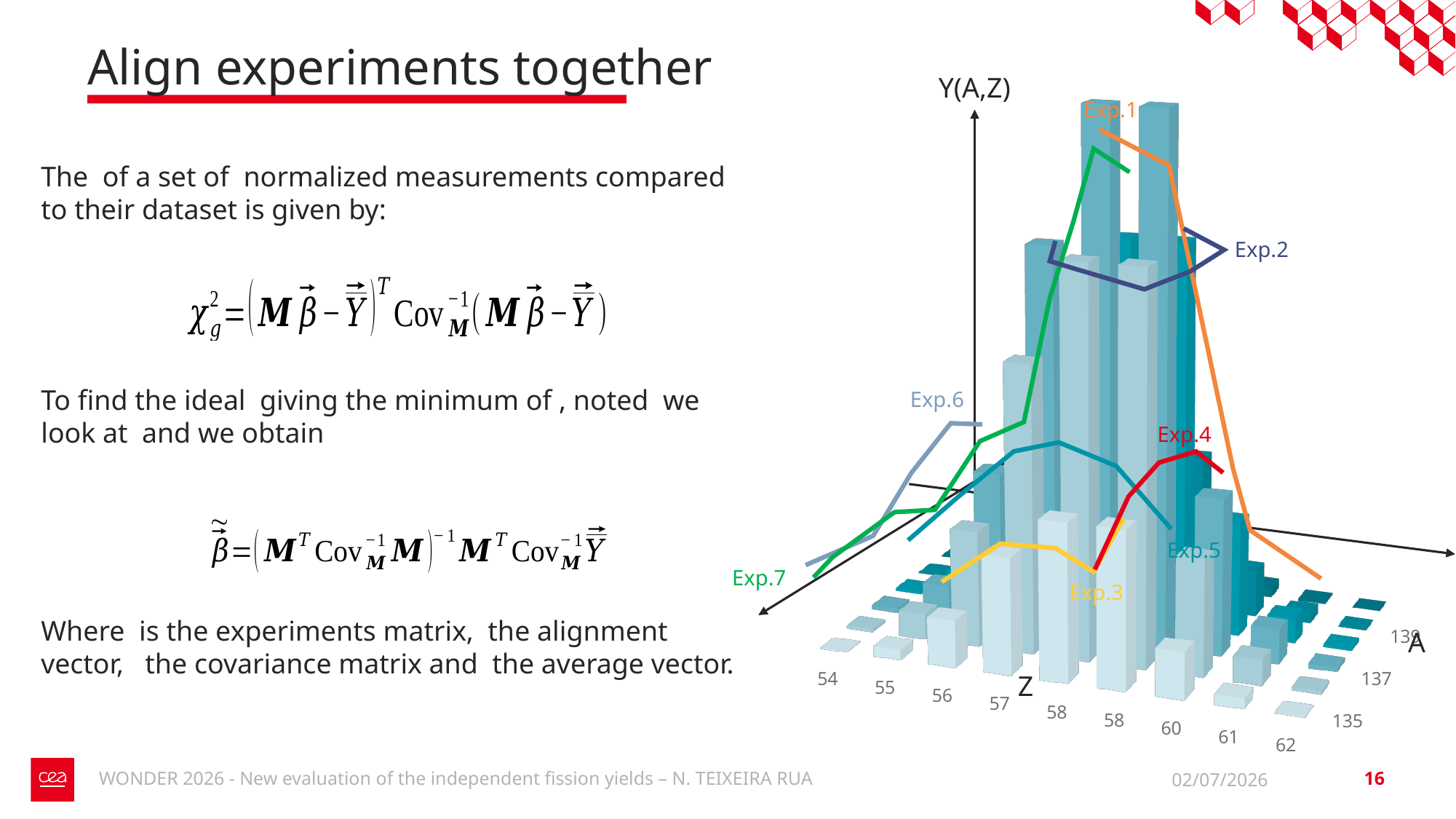
What is the lowest Z value labelled on the chart's Z axis? 54 Which experiment line on the chart is drawn in green? Exp.7 How many experiment lines (Exp.1 to Exp.7) are labelled on the chart? 7 What is the label of the vertical axis of the chart? Y(A,Z) Do the bar heights rise or fall as Z increases from 60 to 62? fall What is the highest Z value labelled on the chart's Z axis? 62 Do the bar heights rise or fall as Z increases from 54 to 57? rise How many tick labels are printed along the Z axis of the chart? 9 What kind of chart is shown on the slide? 3D bar chart What is the lowest A value labelled on the chart's A axis? 135